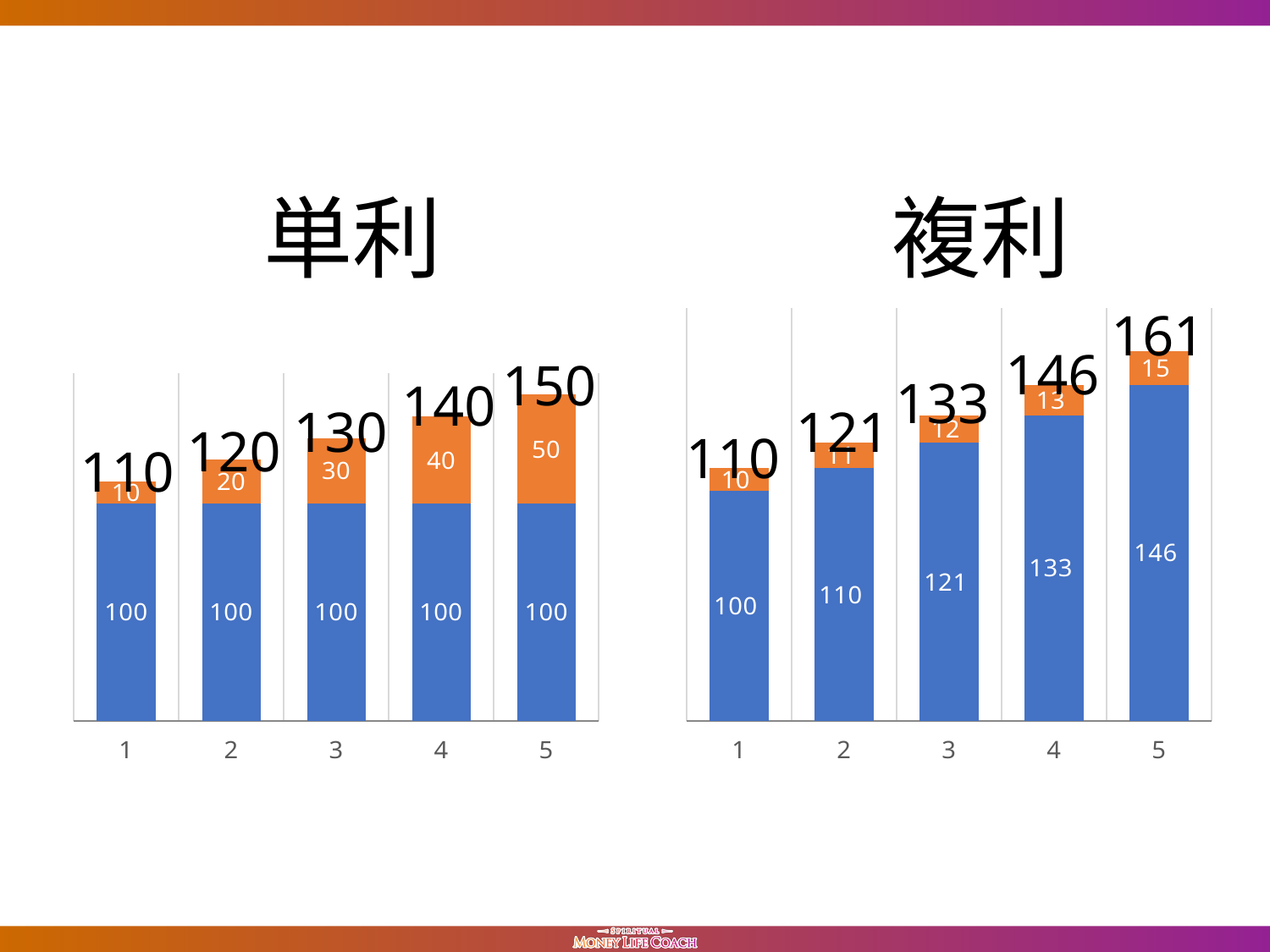
In the 複利 chart, what is the value of the orange segment for category 4? 13 In the 複利 chart, which category has the highest total? 5 Which is larger: the category 3 total in the 複利 chart or the category 3 total in the 単利 chart? 複利 (133) In the 単利 chart, what is the value of the blue segment for category 4? 100 What is the difference between the category 5 total in the 複利 chart and the category 5 total in the 単利 chart? 11 In the 単利 chart, what is the total of the stacked bar for category 5? 150 In the 複利 chart, what is the value of the blue segment for category 5? 146 In the 単利 chart, what is the value of the orange segment for category 3? 30 In the 複利 chart, what is the total of the stacked bar for category 5? 161 What kind of chart is the 単利 chart? Stacked bar chart How many categories are shown on the x axis of the 複利 chart? 5 In the 単利 chart, which category has the lowest total? 1